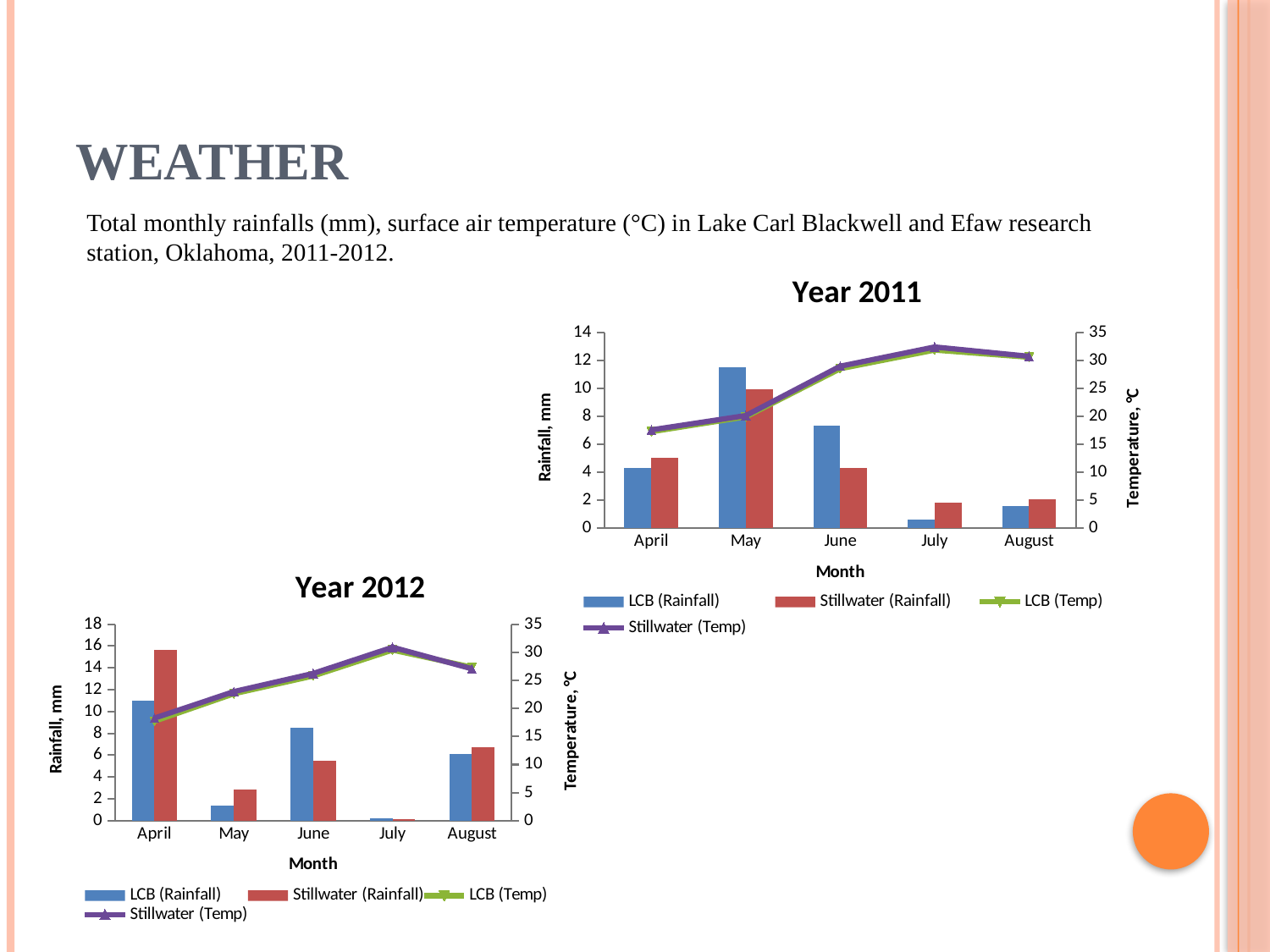
In the Year 2012 chart, is the LCB (Rainfall) value for April greater or less than 10? greater In the Year 2012 chart, does the Stillwater (Temp) line rise or fall from April to July? rise In the Year 2012 chart, which is larger in April: LCB (Rainfall) or Stillwater (Rainfall)? Stillwater (Rainfall) How many series does the legend of the Year 2012 chart list? 4 In the Year 2012 chart, is the LCB (Rainfall) value for July greater or less than 2? less In the Year 2011 chart, which is larger in June: LCB (Rainfall) or Stillwater (Rainfall)? LCB (Rainfall) In the Year 2012 chart, which month has the highest Stillwater (Rainfall) bar? April What kind of chart is the Year 2011 chart? Combination bar and line chart How many months are shown on the x axis of the Year 2011 chart? 5 In the Year 2011 chart, which month has the lowest LCB (Rainfall) bar? July In the Year 2011 chart, which month has the highest LCB (Rainfall) bar? May In the Year 2011 chart, is the Stillwater (Rainfall) value for May greater or less than 8? greater